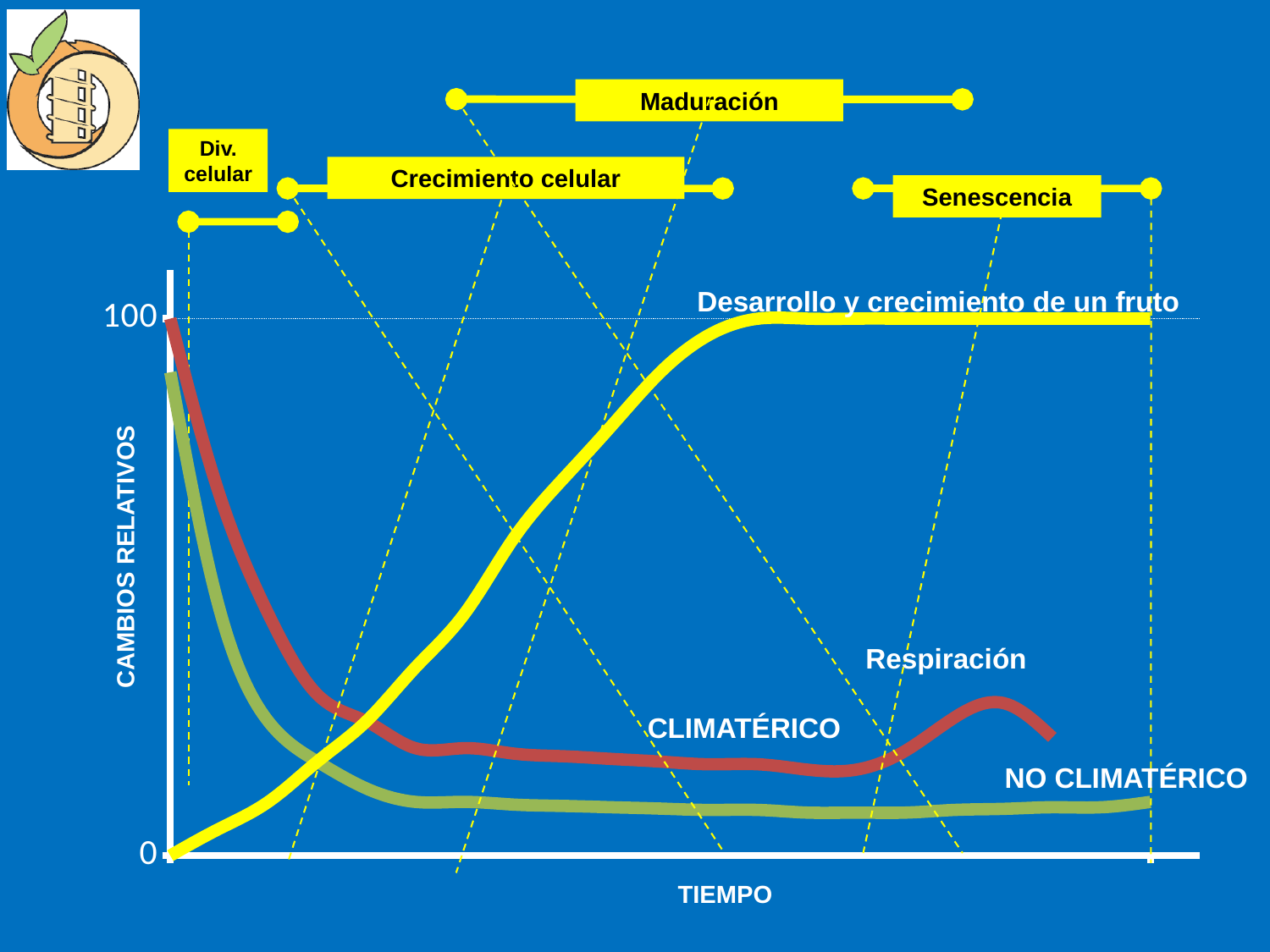
At the right end of the chart, which respiration curve is higher, CLIMATÉRICO or NO CLIMATÉRICO? CLIMATÉRICO What is the label of the y axis? CAMBIOS RELATIVOS Does the 'NO CLIMATÉRICO' respiration curve rise or fall overall along the x axis? Falls Does the curve 'Desarrollo y crecimiento de un fruto' rise or fall along the x axis? Rises What is the label of the x axis? TIEMPO What kind of chart is shown on the slide? Line chart What value does the 'Desarrollo y crecimiento de un fruto' curve reach at the right end of the chart? 100 What value does the 'Desarrollo y crecimiento de un fruto' curve start at on the left of the chart? 0 Which respiration curve shows a rise to a peak late in the time axis? CLIMATÉRICO How many curves are plotted on the chart? 3 Is the value of the CLIMATÉRICO curve at its late peak greater or less than 100? less How many developmental phases are labelled above the chart? 4